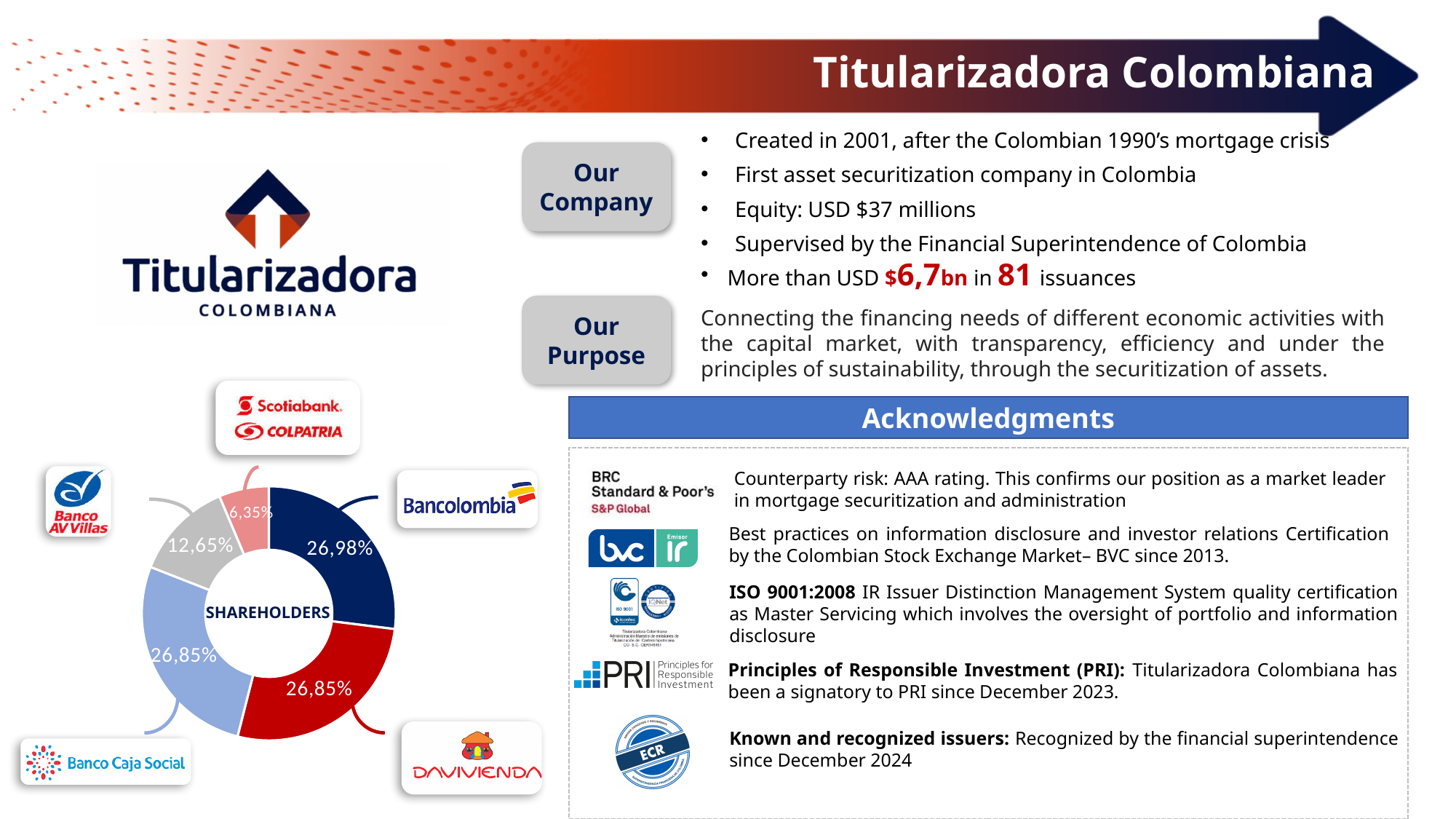
In the SHAREHOLDERS chart, which is larger: the share of Banco AV Villas or the share of Scotiabank Colpatria? Banco AV Villas What colour is the Davivienda slice in the SHAREHOLDERS chart? Red What share does Scotiabank Colpatria hold in the SHAREHOLDERS chart? 6,35% What kind of chart is the SHAREHOLDERS chart? Pie (donut) chart What share of shareholders does Bancolombia hold in the SHAREHOLDERS chart? 26,98% What share does Davivienda hold in the SHAREHOLDERS chart? 26,85% What is the difference between Banco AV Villas' share and Scotiabank Colpatria's share in the SHAREHOLDERS chart? 6,30% Which shareholder has the smallest share in the SHAREHOLDERS chart? Scotiabank Colpatria What share does Banco AV Villas hold in the SHAREHOLDERS chart? 12,65% Which shareholder has the largest share in the SHAREHOLDERS chart? Bancolombia What is the difference between Bancolombia's share and Scotiabank Colpatria's share in the SHAREHOLDERS chart? 20,63% How many shareholders are shown as slices in the SHAREHOLDERS chart? 5